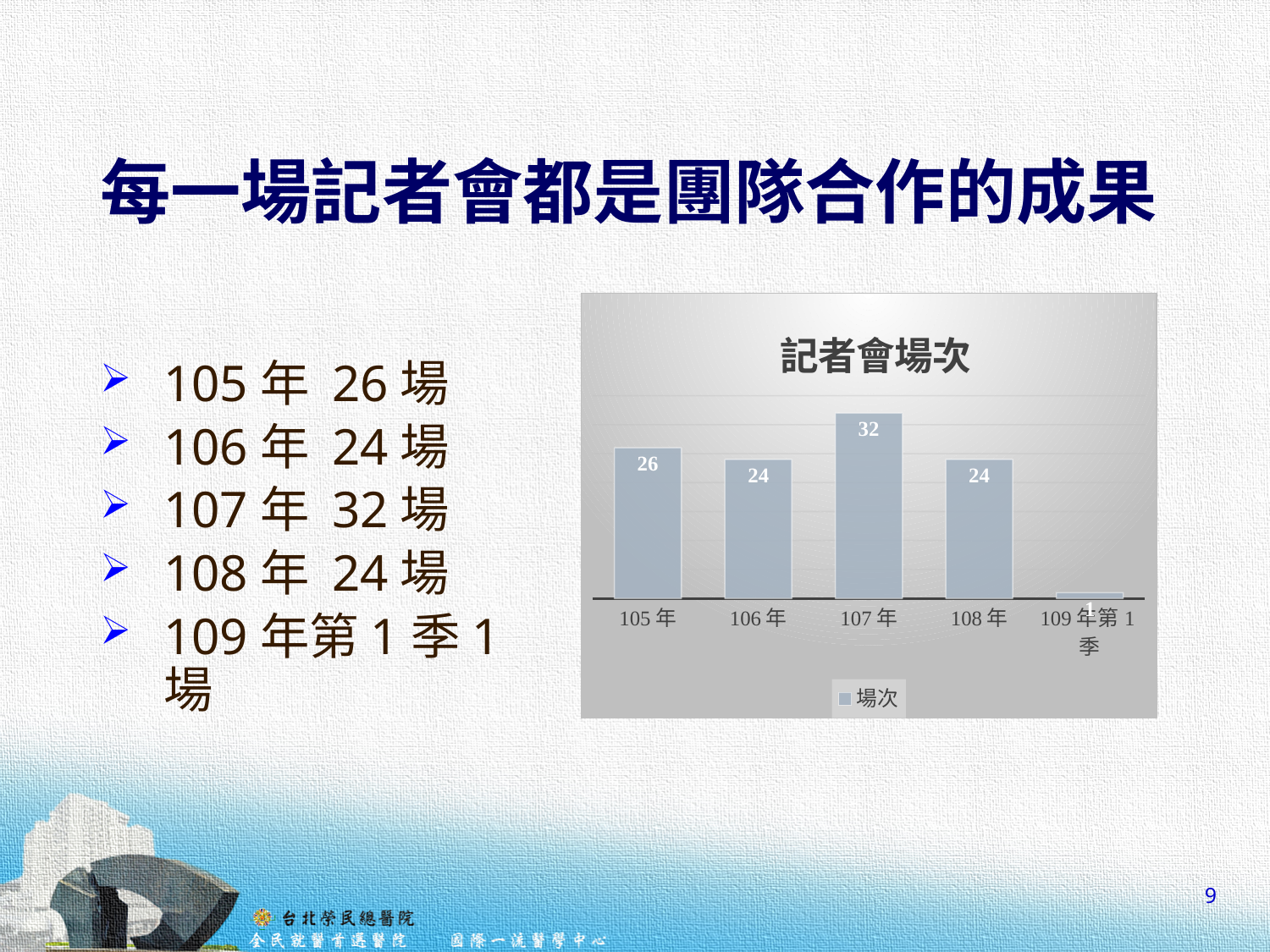
How many categories are shown on the x axis of the chart? 5 What is the name of the series shown in the chart legend? 場次 What is the value for 105 年 in the chart? 26 Which is larger, the value for 105 年 or the value for 106 年? 105 年 How many series does the chart legend list? 1 What is the title of the chart? 記者會場次 What is the value for 107 年 in the chart? 32 What is the difference between the values for 107 年 and 106 年? 8 What type of chart is shown on the slide? bar chart Which category has the lowest value in the chart? 109 年第 1 季 What is the value for 108 年 in the chart? 24 Which category has the highest value in the chart? 107 年